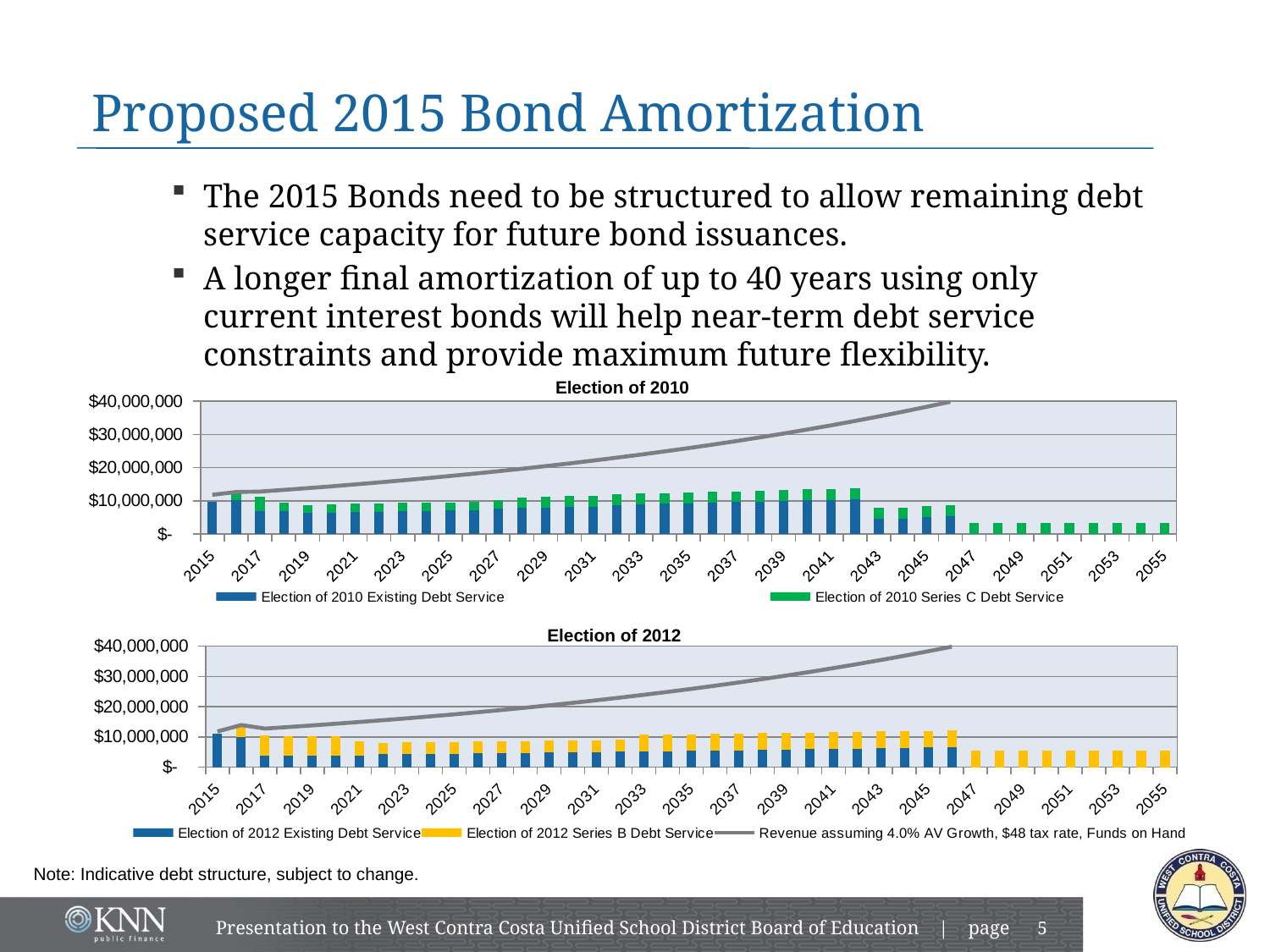
How many series does the legend of the "Election of 2010" chart list? 2 In the "Election of 2010" chart, which is larger: the total stacked debt service in 2040 or in 2050? 2040 What kind of chart is the "Election of 2010" chart? Combination bar and line chart What is the title of the lower chart on the slide? Election of 2012 In the "Election of 2010" chart, is the total stacked debt service for 2040 greater or less than $10,000,000? greater In the "Election of 2010" chart, is the total stacked debt service for 2050 greater or less than $10,000,000? less In the "Election of 2012" chart, what colour represents Election of 2012 Series B Debt Service? Yellow In the "Election of 2012" chart, does the revenue line rise or fall from 2015 to 2045? Rises How many series does the legend of the "Election of 2012" chart list? 3 In the "Election of 2012" chart, is the total stacked debt service for 2055 greater or less than $10,000,000? less